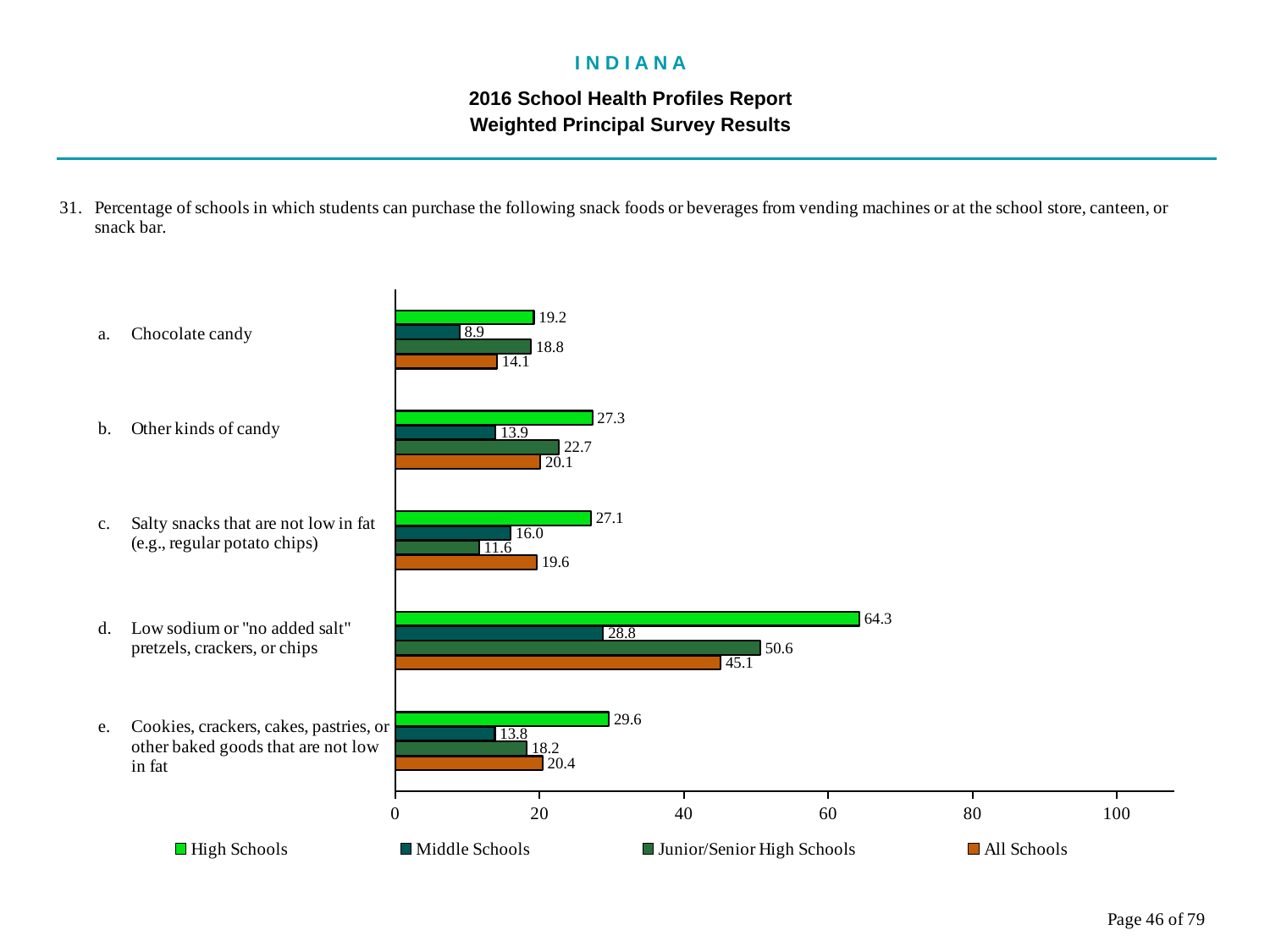
What is the value for Junior/Senior High Schools for Cookies, crackers, cakes, pastries, or other baked goods that are not low in fat? 18.2 Which series is shown in orange in the legend? All Schools What is the value for Middle Schools for Other kinds of candy? 13.9 What is the value for All Schools for Low sodium or "no added salt" pretzels, crackers, or chips? 45.1 Which is larger for Salty snacks that are not low in fat: the Middle Schools value or the Junior/Senior High Schools value? Middle Schools What kind of chart is shown on the slide? Bar chart How many categories are shown on the chart? 5 How many series does the legend list? 4 Which category has the highest value for High Schools? Low sodium or "no added salt" pretzels, crackers, or chips What is the value for High Schools for Chocolate candy? 19.2 Which category has the lowest value for Middle Schools? Chocolate candy What is the difference between the High Schools and Middle Schools values for Low sodium or "no added salt" pretzels, crackers, or chips? 35.5